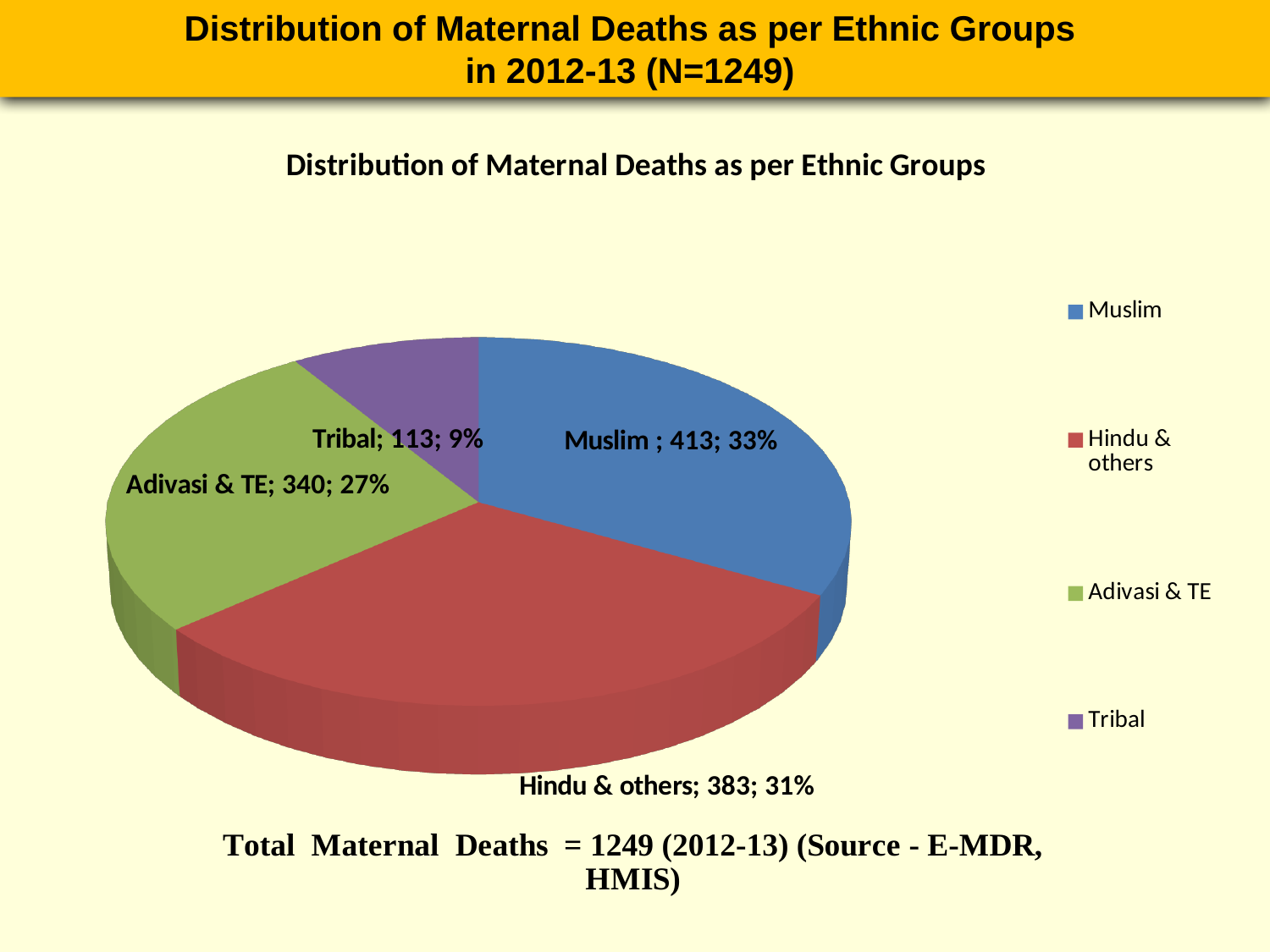
Which has more maternal deaths, Adivasi & TE or Tribal? Adivasi & TE Which ethnic group has the highest number of maternal deaths? Muslim What kind of chart is shown on the slide? pie chart How many maternal deaths are shown for Adivasi & TE? 340 Which ethnic group has the lowest number of maternal deaths? Tribal What colour is the Adivasi & TE slice? green How many ethnic groups are shown in the pie chart? 4 What is the difference in maternal deaths between the Muslim group and Hindu & others? 30 How many entries does the legend list? 4 What percentage share does the Hindu & others slice have? 31% How many maternal deaths are shown for the Muslim group? 413 What percentage share does the Tribal slice have? 9%